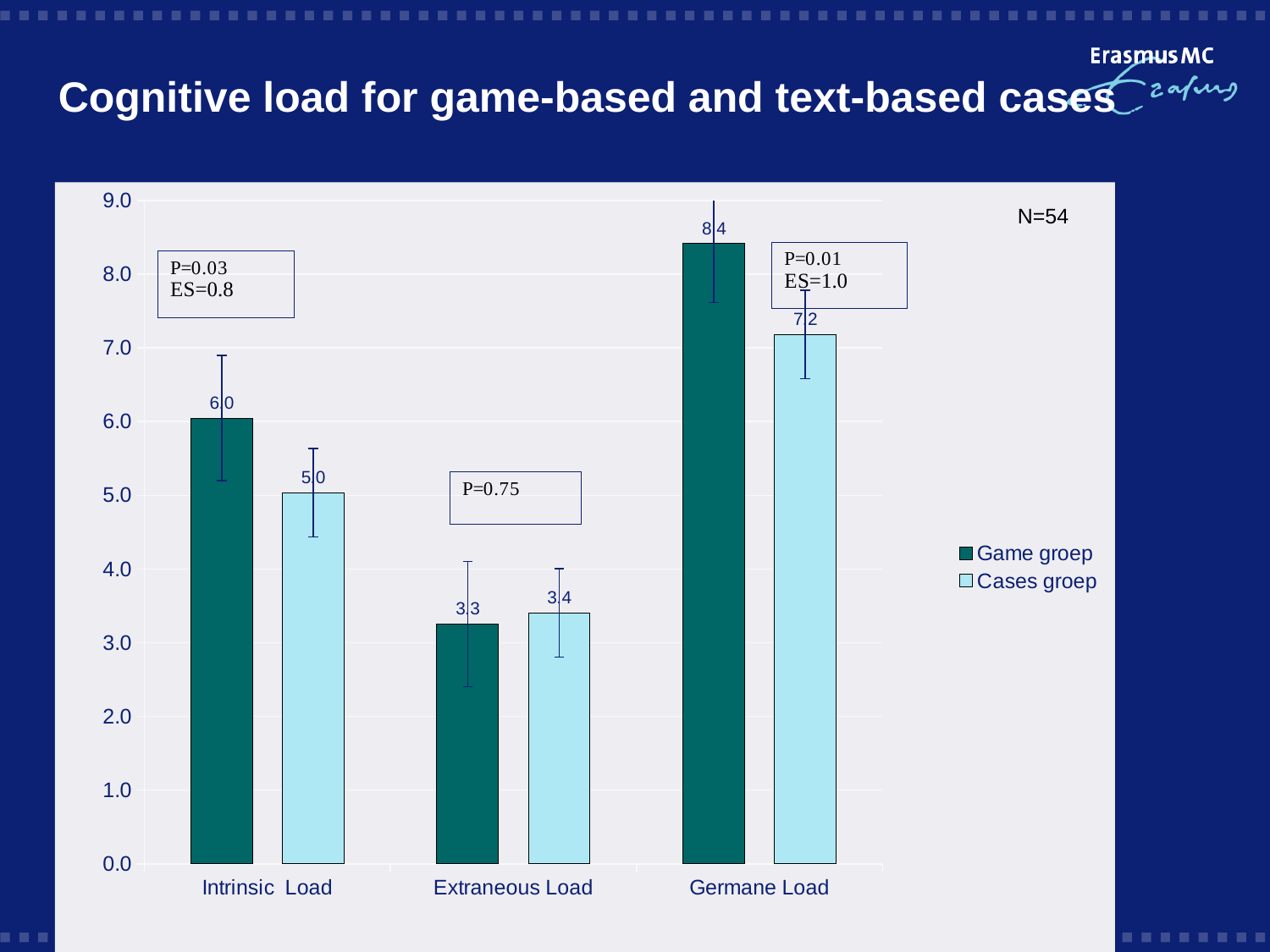
What is the difference between Game groep and Cases groep at Germane Load? 1.2 What is the value for Game groep at Intrinsic Load? 6.0 How many series does the legend list? 2 How many categories are shown on the x axis? 3 Is the value for Game groep at Germane Load greater or less than 8.0? greater What is the value for Cases groep at Extraneous Load? 3.4 Which category has the highest value for Game groep? Germane Load What is the value for Cases groep at Germane Load? 7.2 What is the difference between Game groep and Cases groep at Intrinsic Load? 1.0 What kind of chart is shown on the slide? Bar chart Which category has the lowest value for Cases groep? Extraneous Load Which is larger at Intrinsic Load, Game groep or Cases groep? Game groep